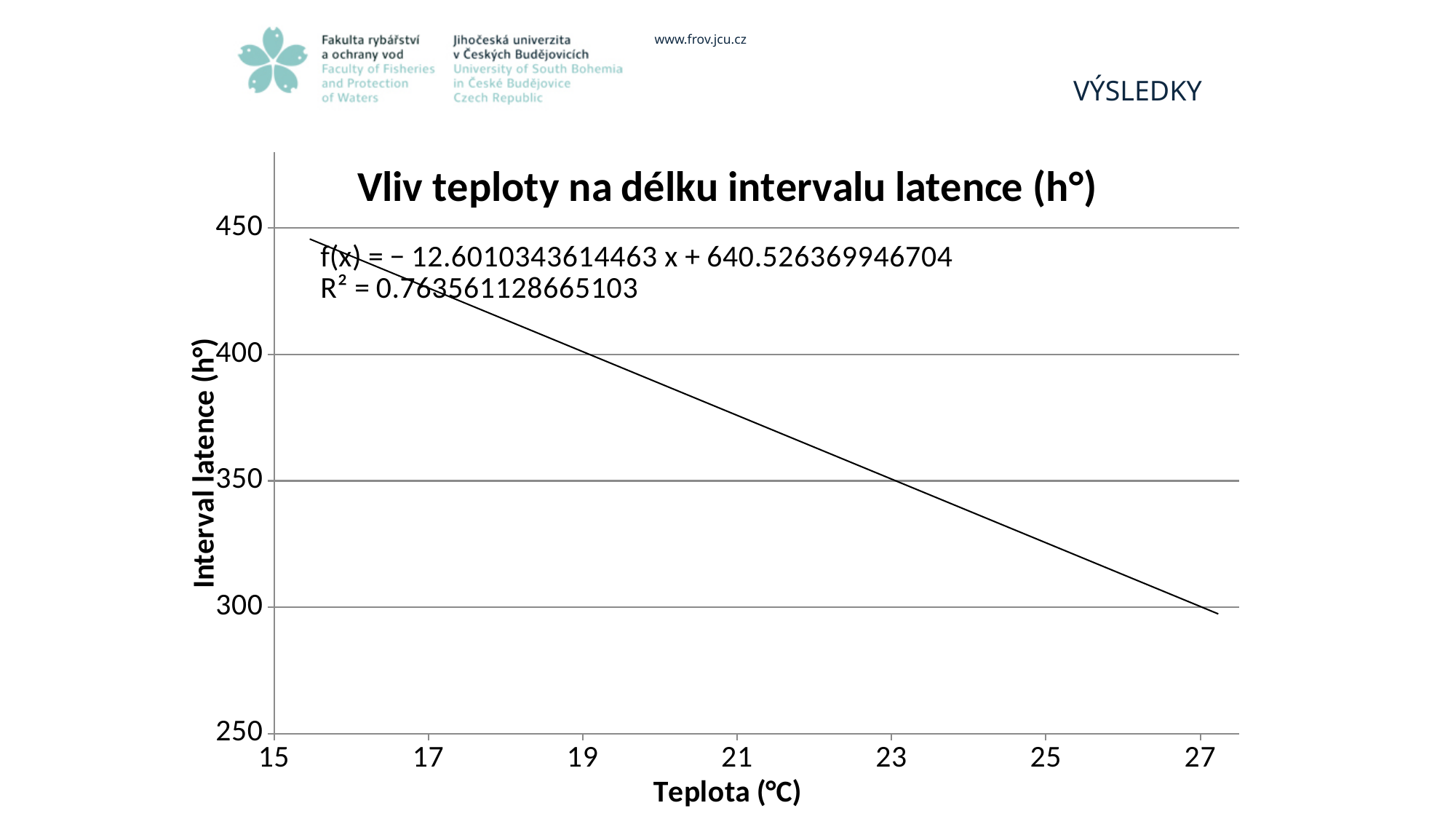
Is the value of the line at 16 °C greater or less than 400? greater Is the value of the line at 26 °C greater or less than 350? less Does the interval latence rise or fall as temperature increases along the x axis? fall What is the highest value shown on the y axis? 450 Is the value of the line at 15 °C greater or less than 400? greater What is the title of the chart? Vliv teploty na délku intervalu latence (h°) What kind of chart is shown on the slide? line chart What is the label of the x axis? Teplota (°C)